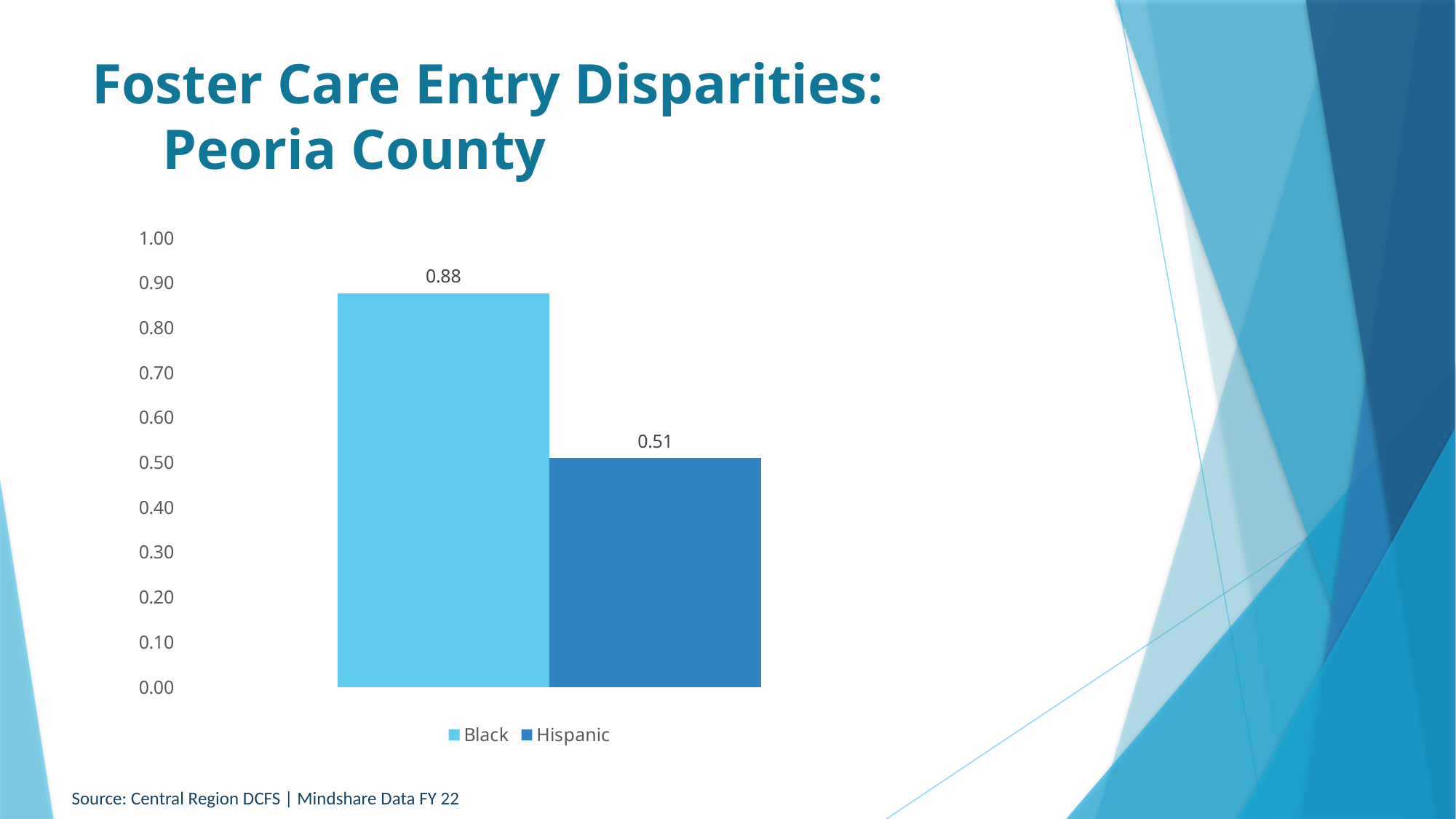
What is the title of the slide? Foster Care Entry Disparities: Peoria County What is the difference between the values for Black and Hispanic? 0.37 What is the value for Black? 0.88 Is the value for Black greater or less than 0.80? greater What is the value for Hispanic? 0.51 Which series has the lowest value? Hispanic What is the maximum value shown on the vertical axis? 1.00 What kind of chart is shown on the slide? bar chart Which series has the highest value? Black How many series does the legend list? 2 Is the value for Hispanic greater or less than 0.60? less Which is larger, the value for Black or the value for Hispanic? Black